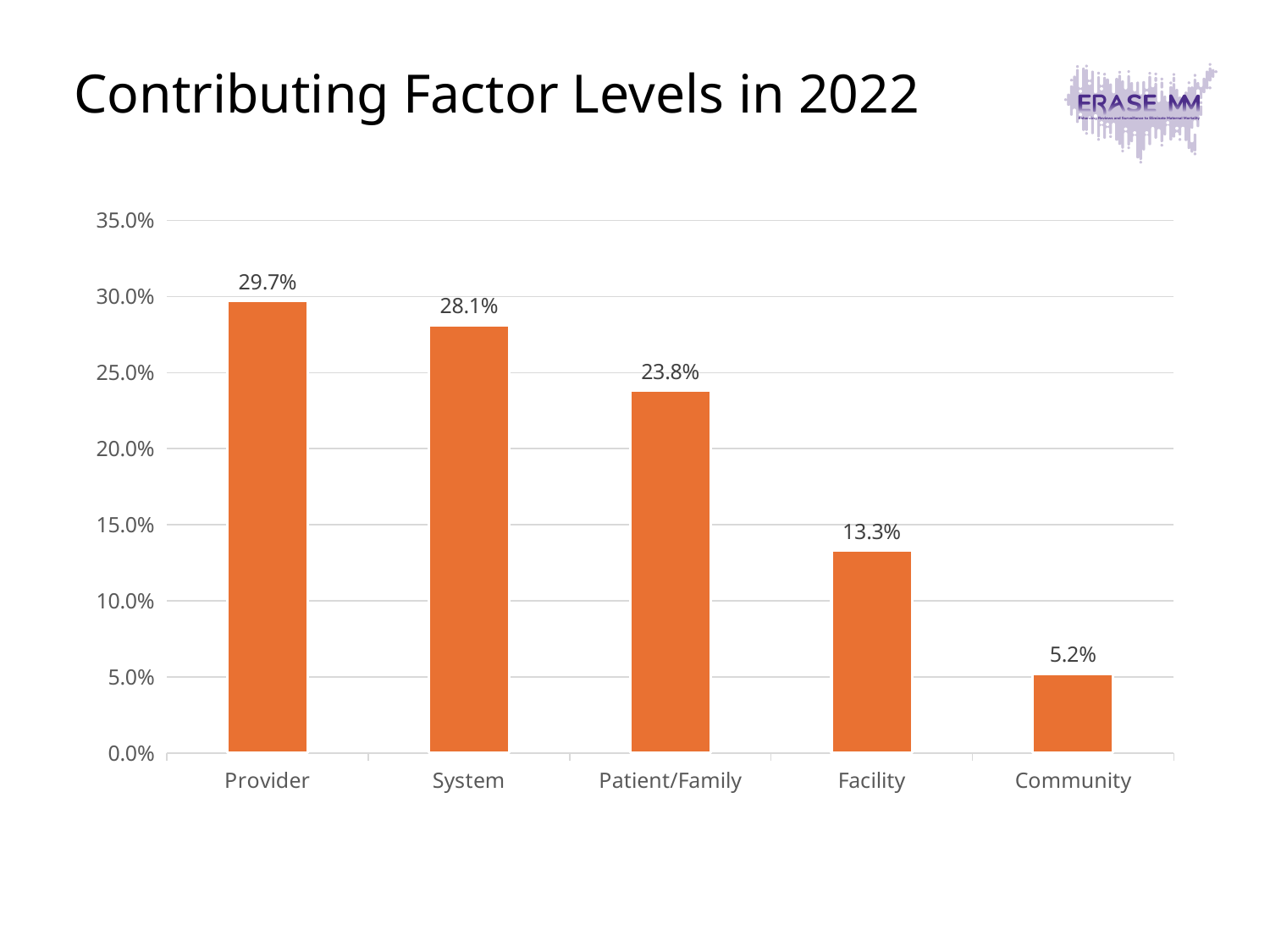
Do the values rise or fall from left to right along the x axis? fall What kind of chart is shown on the slide? bar chart Which is larger, the value for System or the value for Patient/Family? System Which category has the lowest value? Community How many categories are shown on the x axis? 5 Which category has the highest value? Provider Is the value for Facility greater or less than 15.0%? less What is the value for Community? 5.2% What is the difference between the values for Provider and System? 1.6% What is the value for Patient/Family? 23.8% What is the value for Provider? 29.7% What is the difference between the values for Facility and Community? 8.1%